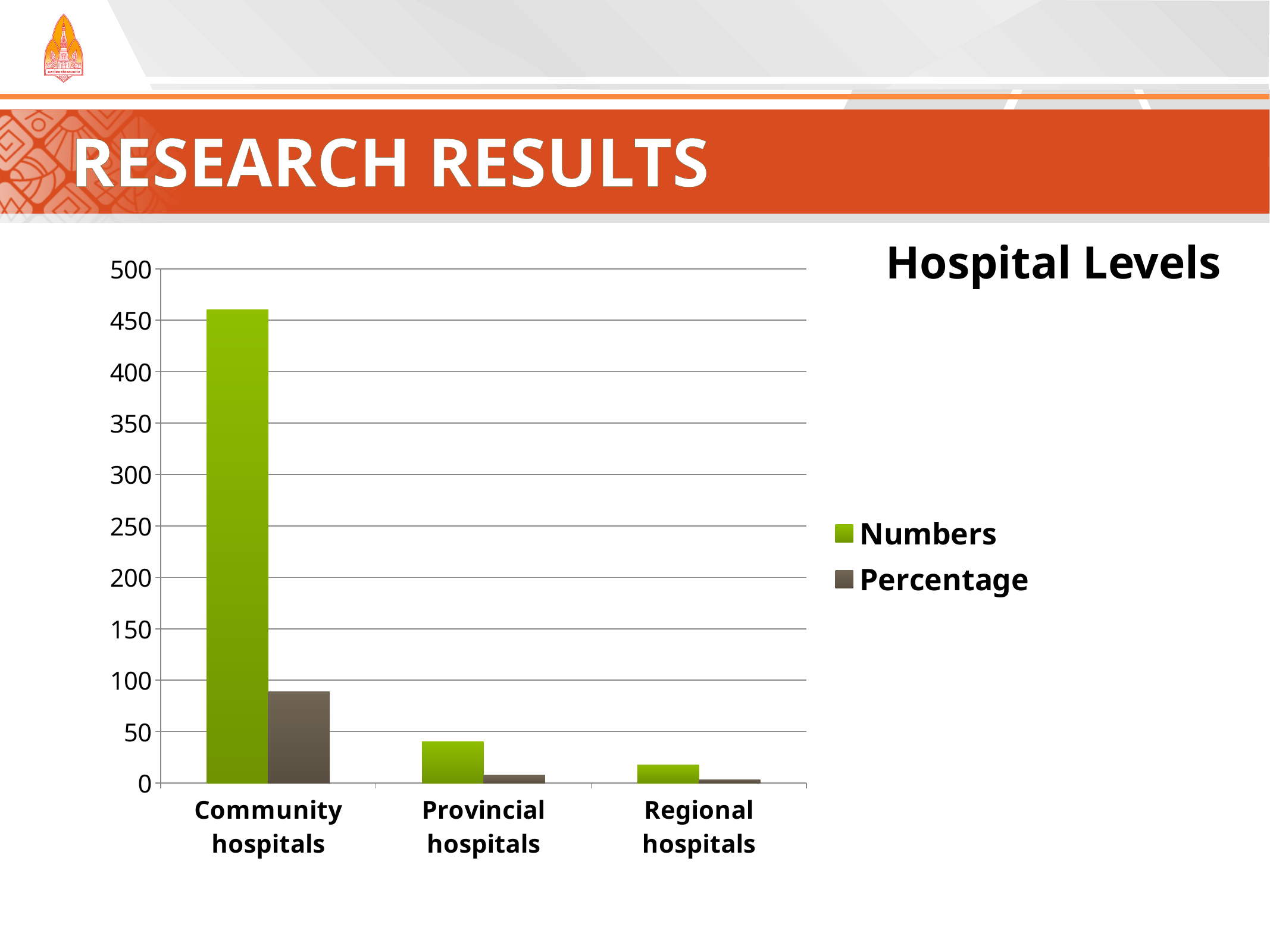
Which category has the highest value for Numbers? Community hospitals What kind of chart is shown on the slide? bar chart Do the Numbers values rise or fall from Community hospitals to Regional hospitals along the x axis? fall Which series is shown in green? Numbers Is the Numbers value for Provincial hospitals greater or less than 50? less What is the title of the chart? Hospital Levels Which is larger, the Numbers value for Provincial hospitals or the Numbers value for Regional hospitals? Provincial hospitals Which category has the lowest value for Numbers? Regional hospitals Is the Percentage value for Community hospitals greater or less than 100? less How many hospital categories are shown on the x axis? 3 How many series does the legend list? 2 Is the Numbers value for Community hospitals greater or less than 400? greater